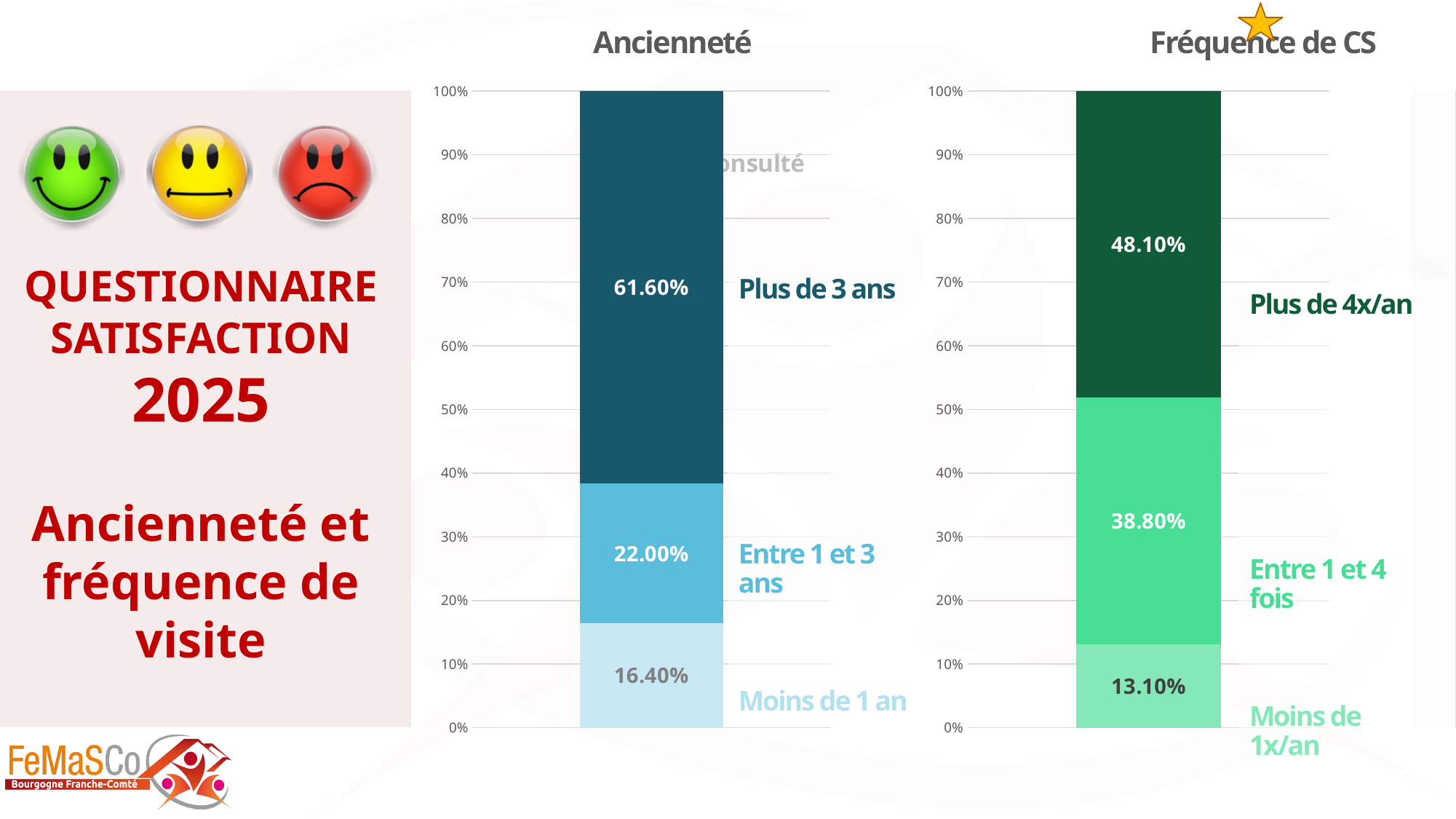
How many segments make up the stacked bar in the 'Ancienneté' chart? 3 In the 'Fréquence de CS' chart, what is the difference between 'Plus de 4x/an' and 'Entre 1 et 4 fois'? 9.30% In the 'Fréquence de CS' chart, what is the value for 'Moins de 1x/an'? 13.10% In the 'Fréquence de CS' chart, which segment has the lowest value? Moins de 1x/an In the 'Ancienneté' chart, what is the difference between 'Plus de 3 ans' and 'Entre 1 et 3 ans'? 39.60% In the 'Ancienneté' chart, what is the value for 'Plus de 3 ans'? 61.60% In the 'Ancienneté' chart, what is the value for 'Moins de 1 an'? 16.40% What type of chart is the 'Fréquence de CS' chart? Stacked bar chart In the 'Ancienneté' chart, which segment has the highest value? Plus de 3 ans In the 'Fréquence de CS' chart, which is larger: 'Plus de 4x/an' or 'Entre 1 et 4 fois'? Plus de 4x/an In the 'Fréquence de CS' chart, what is the value for 'Entre 1 et 4 fois'? 38.80% What is the title of the chart on the right side of the slide? Fréquence de CS